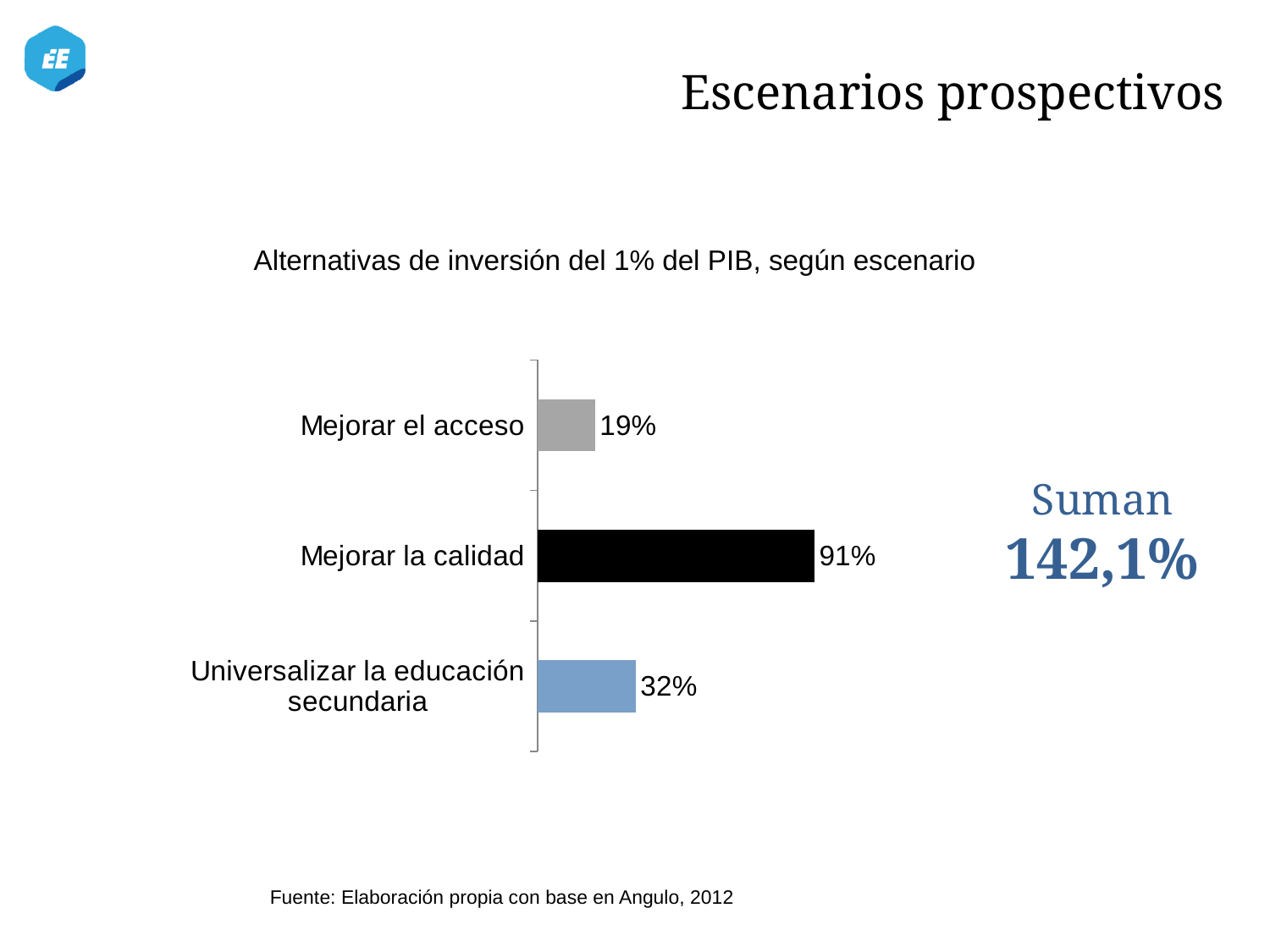
How many categories are shown in the chart? 3 What is the value for "Mejorar el acceso"? 19% What is the title of the chart? Alternativas de inversión del 1% del PIB, según escenario What is the value for "Universalizar la educación secundaria"? 32% What is the difference between the values for "Mejorar la calidad" and "Mejorar el acceso"? 72% Which is larger, the value for "Universalizar la educación secundaria" or the value for "Mejorar el acceso"? Universalizar la educación secundaria What total is stated next to the chart under "Suman"? 142,1% Which category has the highest value? Mejorar la calidad What is the difference between the values for "Universalizar la educación secundaria" and "Mejorar el acceso"? 13% Which category has the lowest value? Mejorar el acceso What kind of chart is shown on the slide? Bar chart What is the value for "Mejorar la calidad"? 91%